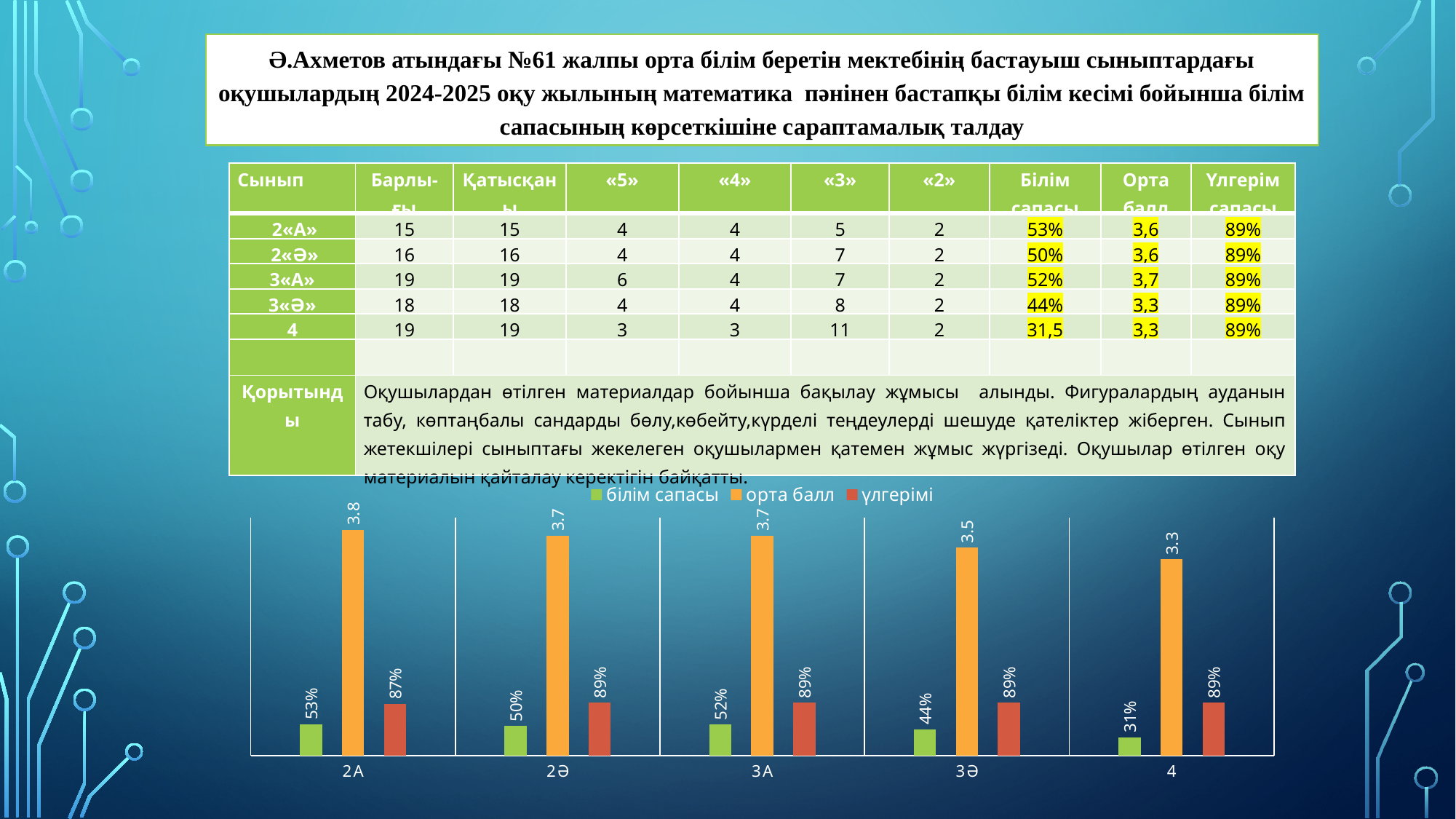
Which is larger in the chart: the орта балл for class 2А or for class 3Ә? 2А Which colour represents the орта балл series in the chart? orange What is the орта балл value for class 3Ә in the chart? 3.5 Which class has the highest білім сапасы value in the chart? 2А What is the difference between the білім сапасы values for class 2А and class 4 in the chart? 22% What is the орта балл value for class 4 in the chart? 3.3 What is the үлгерімі value for class 2А in the chart? 87% Which class has the lowest орта балл value in the chart? 4 What kind of chart is shown on the slide? bar chart What is the value of білім сапасы for class 2А in the chart? 53% How many classes are shown on the x axis of the chart? 5 How many series does the chart legend list? 3